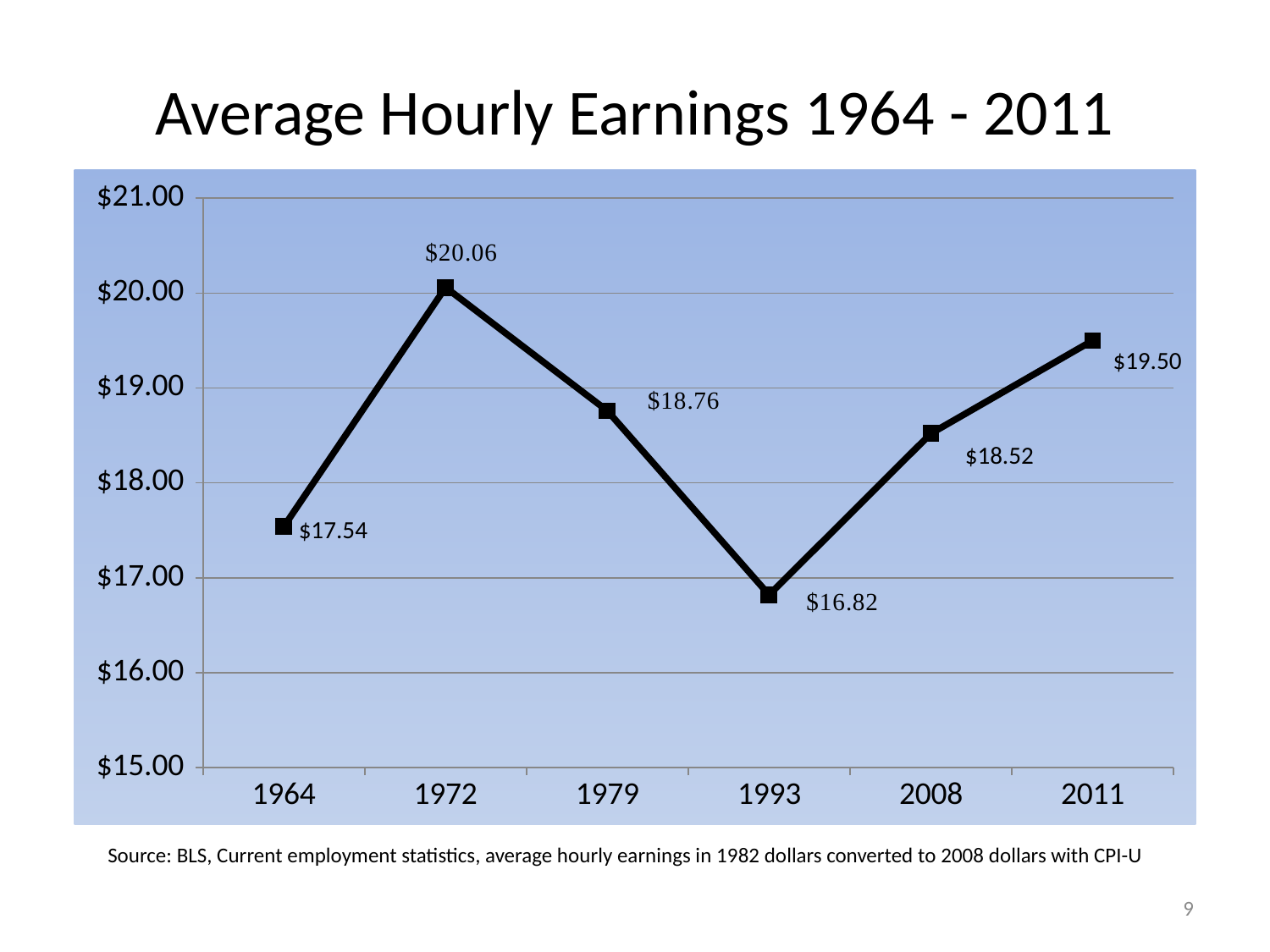
What is the difference between the 2011 value and the 2008 value? $0.98 Which year has the lowest average hourly earnings? 1993 What kind of chart is shown on the slide? line chart Which is larger, the value for 1979 or the value for 2008? 1979 What is the average hourly earnings value for 1993? $16.82 Which year has the highest average hourly earnings? 1972 Is the value for 1964 greater or less than $18.00? less How many years are plotted on the chart? 6 Do the values rise or fall from 1993 to 2011? rise What is the average hourly earnings value for 2011? $19.50 What is the average hourly earnings value for 1972? $20.06 What is the difference between the 1972 value and the 1993 value? $3.24